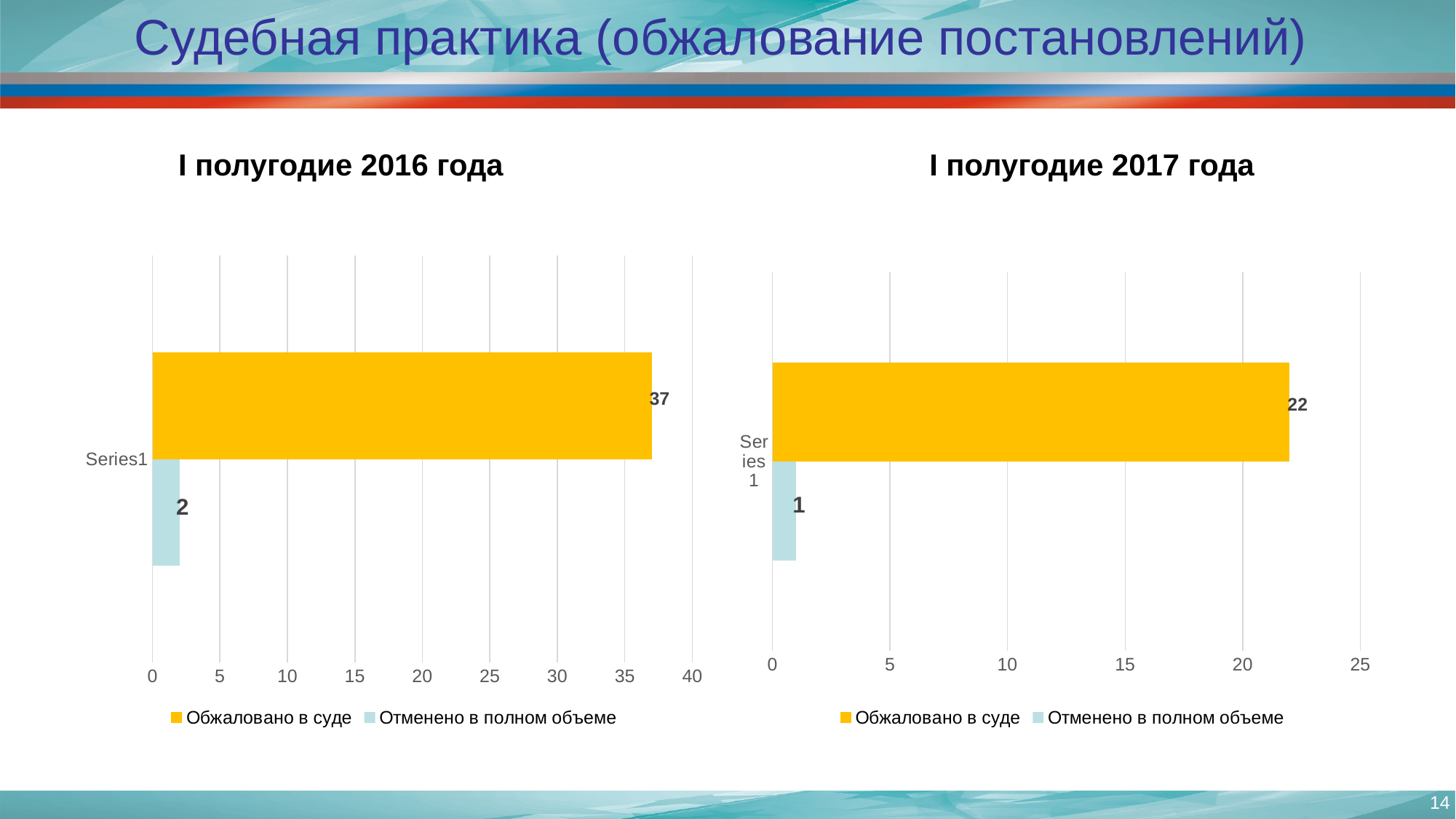
In the 'I полугодие 2017 года' chart, what colour is the bar for 'Обжаловано в суде'? yellow In the 'I полугодие 2017 года' chart, which series has the smaller value? Отменено в полном объеме What kind of chart is the 'I полугодие 2016 года' chart? bar chart How many series does the legend of the 'I полугодие 2017 года' chart list? 2 In the 'I полугодие 2016 года' chart, which series has the larger value? Обжаловано в суде In the 'I полугодие 2017 года' chart, what is the value for 'Обжаловано в суде'? 22 In the 'I полугодие 2016 года' chart, what is the value for 'Обжаловано в суде'? 37 In the 'I полугодие 2017 года' chart, what is the difference between 'Обжаловано в суде' and 'Отменено в полном объеме'? 21 In the 'I полугодие 2016 года' chart, what is the difference between 'Обжаловано в суде' and 'Отменено в полном объеме'? 35 In the 'I полугодие 2016 года' chart, is the value for 'Обжаловано в суде' greater or less than 35? greater In the 'I полугодие 2017 года' chart, what is the value for 'Отменено в полном объеме'? 1 In the 'I полугодие 2016 года' chart, what is the value for 'Отменено в полном объеме'? 2